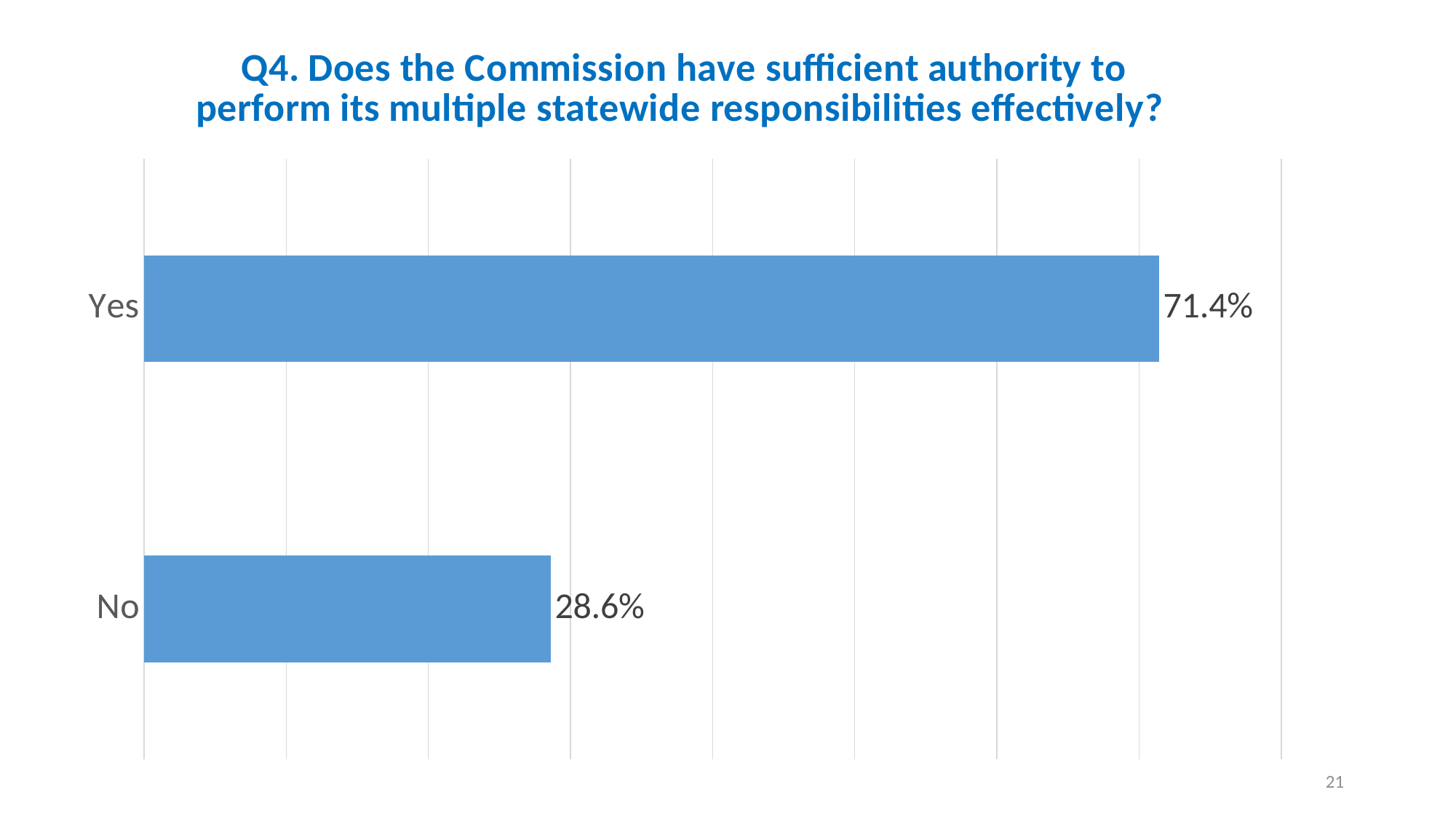
What is the title of the chart? Q4. Does the Commission have sufficient authority to perform its multiple statewide responsibilities effectively? What colour are the bars in the chart? Blue What kind of chart is shown on the slide? Bar chart Which is larger, the value for Yes or the value for No? Yes How many response categories are shown in the chart? 2 What percentage of respondents answered No? 28.6% What is the difference between the Yes and No percentages? 42.8% What is the total of the Yes and No percentages? 100% Which response has the lowest value? No What percentage of respondents answered Yes? 71.4% Which response has the highest value? Yes